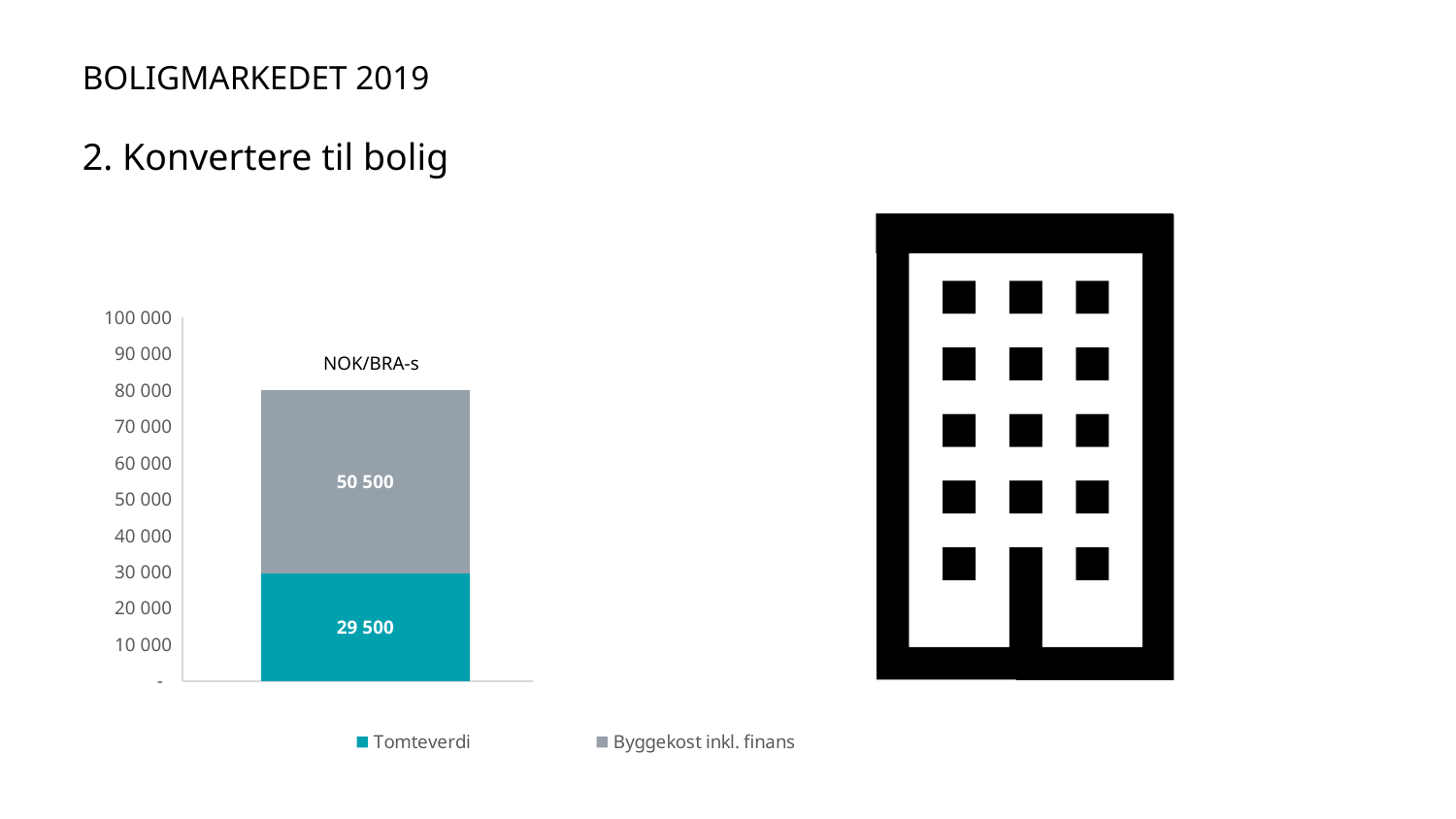
What is the difference between the Byggekost inkl. finans segment and the Tomteverdi segment? 21 000 How many series does the chart legend list? 2 What is the value of the Tomteverdi segment in the bar chart? 29 500 Which series has the smallest value in the stacked bar? Tomteverdi Which segment is larger, Tomteverdi or Byggekost inkl. finans? Byggekost inkl. finans How many bars are plotted in the chart? 1 Which series has the largest value in the stacked bar? Byggekost inkl. finans Is the total height of the stacked bar greater or less than 90 000? less What unit label is shown above the bar in the chart? NOK/BRA-s What kind of chart is shown on the slide? Stacked bar chart What is the total of the stacked bar in the chart? 80 000 What is the value of the Byggekost inkl. finans segment in the bar chart? 50 500